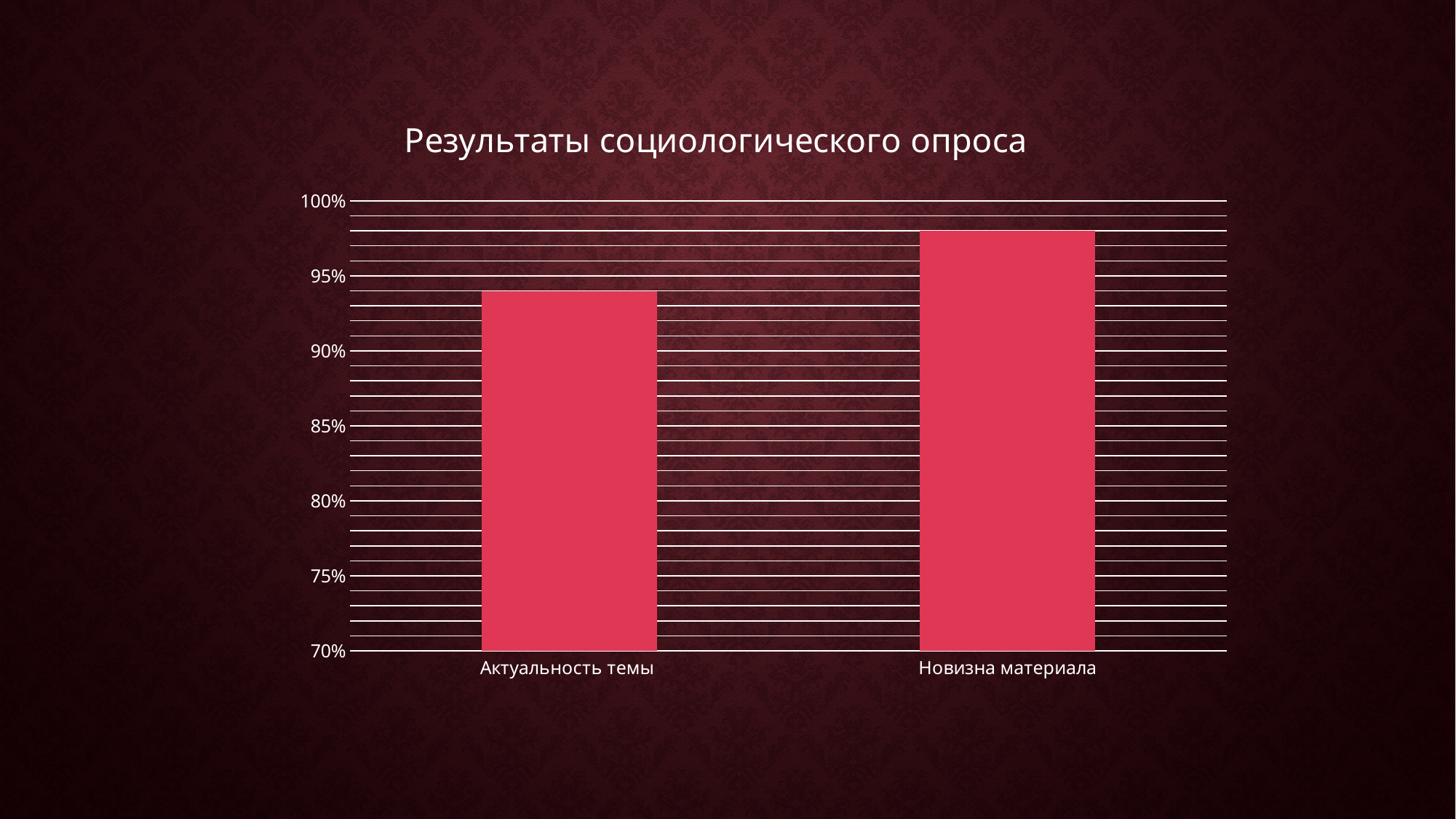
Is the value for Актуальность темы greater or less than 95%? less How many categories are plotted in the chart? 2 Is the value for Новизна материала greater or less than 100%? less Which category has the highest value? Новизна материала Is the value for Новизна материала greater or less than 95%? greater What is the title of the chart? Результаты социологического опроса Which is larger, the value for Актуальность темы or the value for Новизна материала? Новизна материала Do the values rise or fall from the left category to the right category? rise What is the lowest value shown on the vertical axis? 70% Which category has the lowest value? Актуальность темы What kind of chart is shown on the slide? bar chart